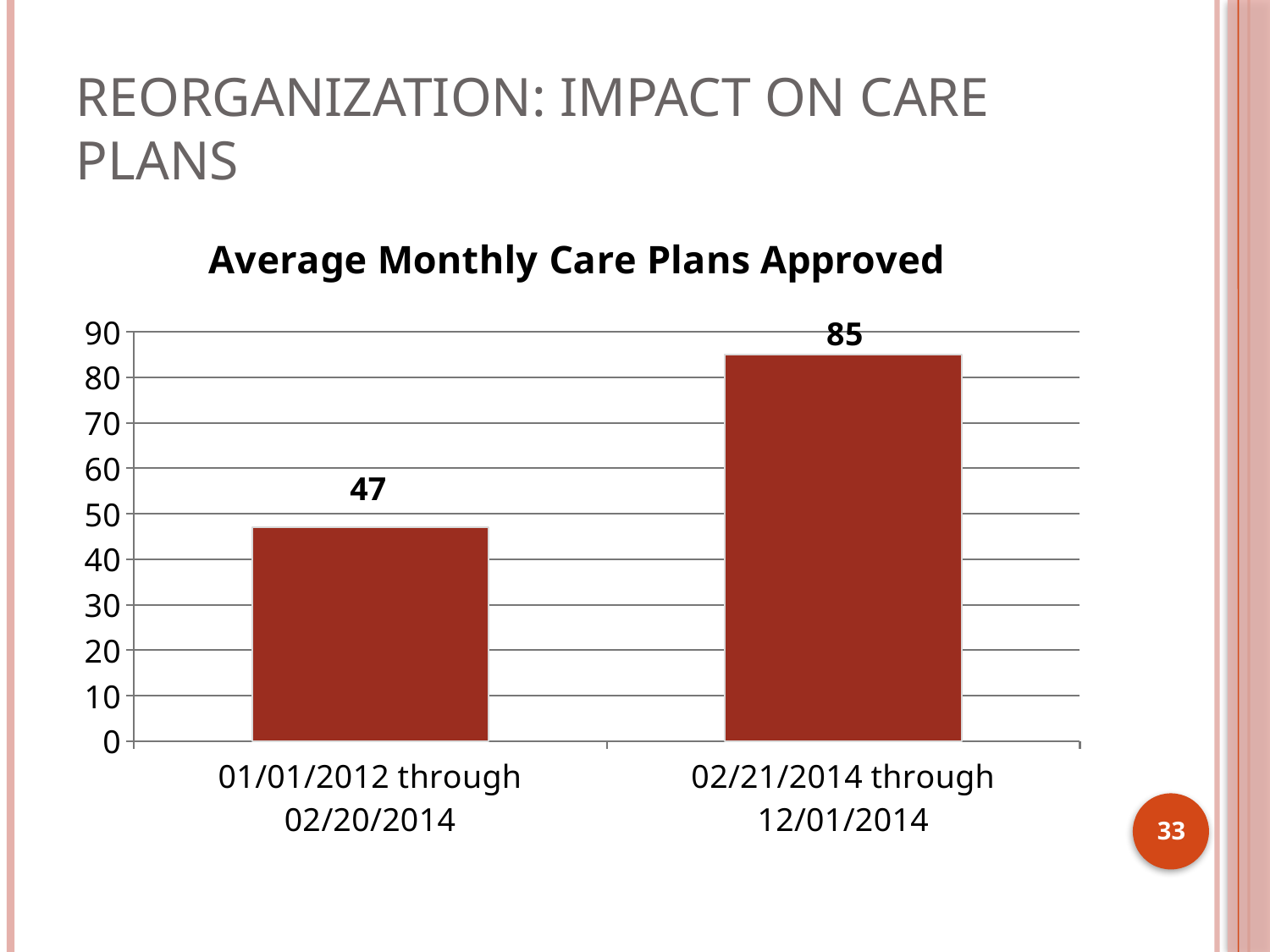
How many categories are shown on the chart? 2 Which period has the lower average monthly care plans approved? 01/01/2012 through 02/20/2014 Is the value for 01/01/2012 through 02/20/2014 larger or smaller than the value for 02/21/2014 through 12/01/2014? smaller What is the average monthly care plans approved for 02/21/2014 through 12/01/2014? 85 Is the value for 01/01/2012 through 02/20/2014 greater or less than 50? less Which period has the higher average monthly care plans approved? 02/21/2014 through 12/01/2014 Do the values rise or fall from the first period to the second? rise What kind of chart is shown on the slide? bar chart What is the difference between the average monthly care plans approved in the two periods? 38 Is the value for 02/21/2014 through 12/01/2014 greater or less than 80? greater What is the average monthly care plans approved for 01/01/2012 through 02/20/2014? 47 What is the title of the chart? Average Monthly Care Plans Approved